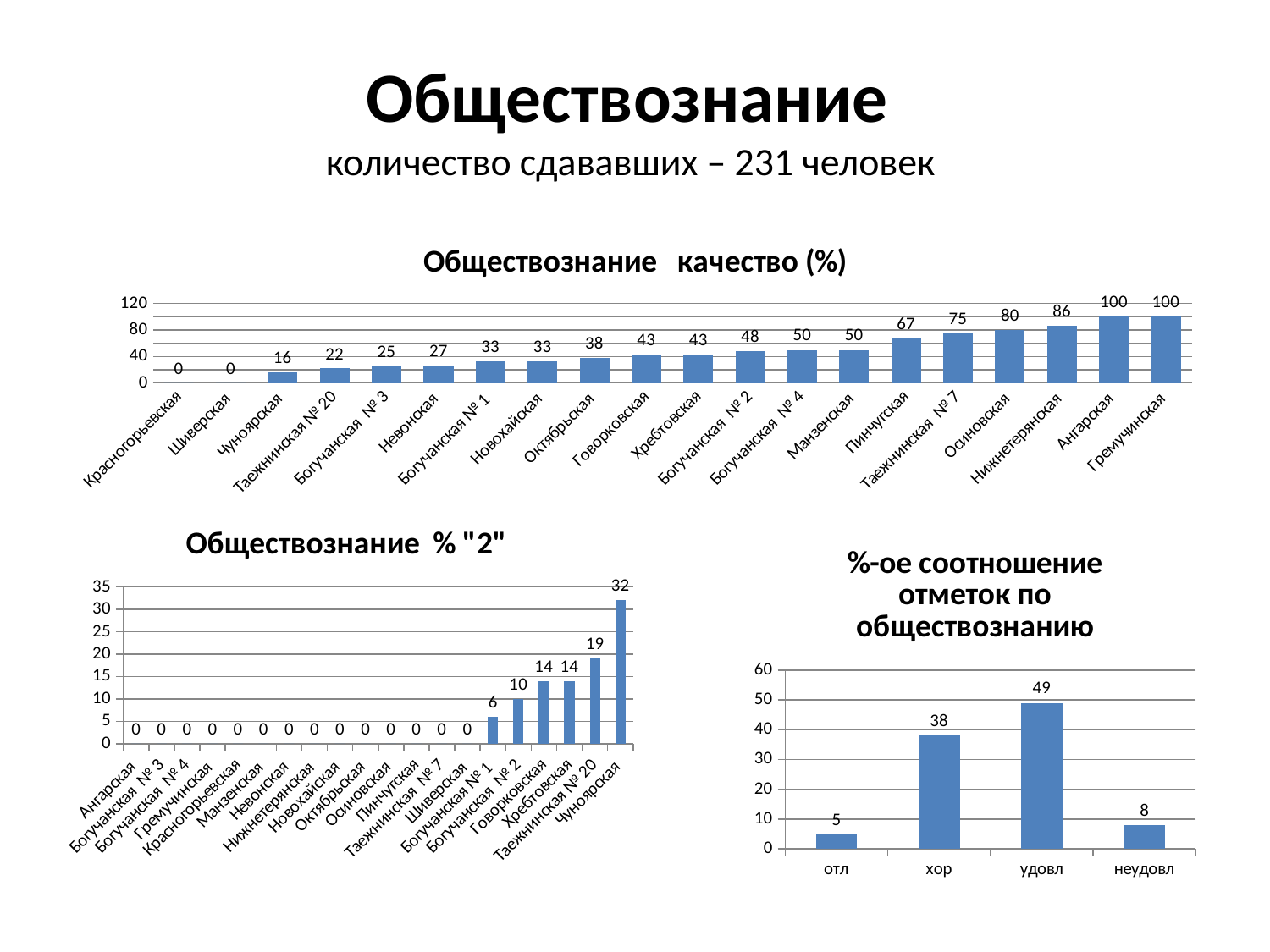
In the chart "Обществознание качество (%)", what is the value for Октябрьская? 38 What kind of chart is "%-ое соотношение отметок по обществознанию"? bar chart In the chart "Обществознание % "2"", what is the difference between the values for Чуноярская and Богучанская № 2? 22 In the chart "Обществознание качество (%)", what is the value for Пинчугская? 67 In the chart "Обществознание качество (%)", which is larger, the value for Осиновская or the value for Таежнинская № 7? Осиновская In the chart "Обществознание качество (%)", how many categories are shown on the x axis? 20 In the chart "%-ое соотношение отметок по обществознанию", which category has the lowest value? отл In the chart "%-ое соотношение отметок по обществознанию", what is the difference between the values for удовл and неудовл? 41 In the chart "Обществознание % "2"", what is the value for Таежнинская № 20? 19 In the chart "%-ое соотношение отметок по обществознанию", what is the value for хор? 38 In the chart "Обществознание % "2"", which category has the highest value? Чуноярская In the chart "Обществознание качество (%)", what is the difference between the values for Нижнетерянская and Чуноярская? 70